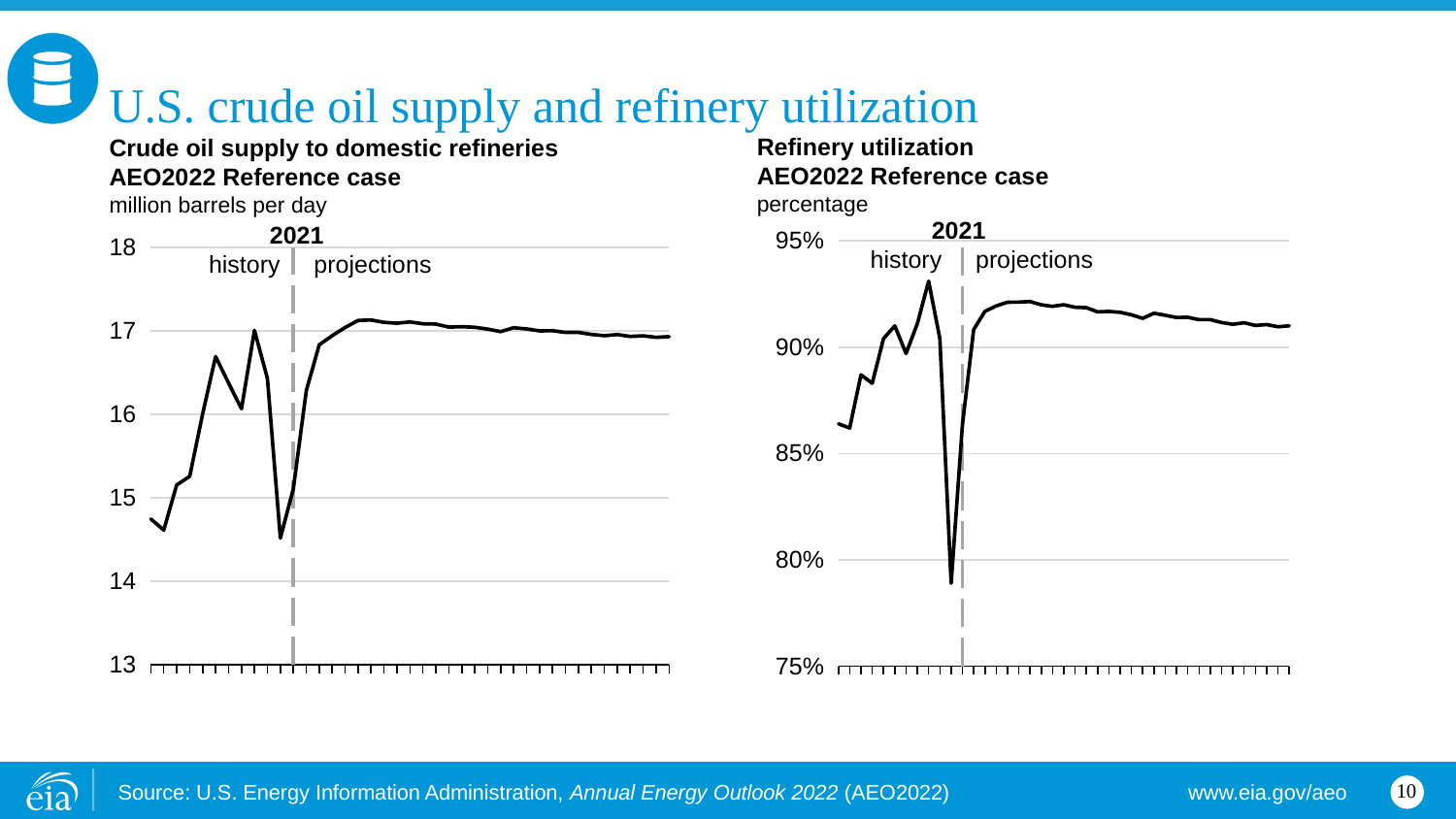
What type of chart is the 'Refinery utilization' chart? line chart In the 'Refinery utilization' chart, is the highest value of the line greater or less than 95%? less In the 'Refinery utilization' chart, do the values rise or fall over the later part of the projections period? fall In the 'Crude oil supply to domestic refineries' chart, is the lowest value of the line greater or less than 15? less What type of chart is the 'Crude oil supply to domestic refineries' chart? line chart Which year separates history from projections in both charts? 2021 In the 'Crude oil supply to domestic refineries' chart, is the highest value of the line greater or less than 18? less What unit is used on the y axis of the 'Crude oil supply to domestic refineries' chart? million barrels per day In the 'Crude oil supply to domestic refineries' chart, do the values rise or fall over the later part of the projections period? fall